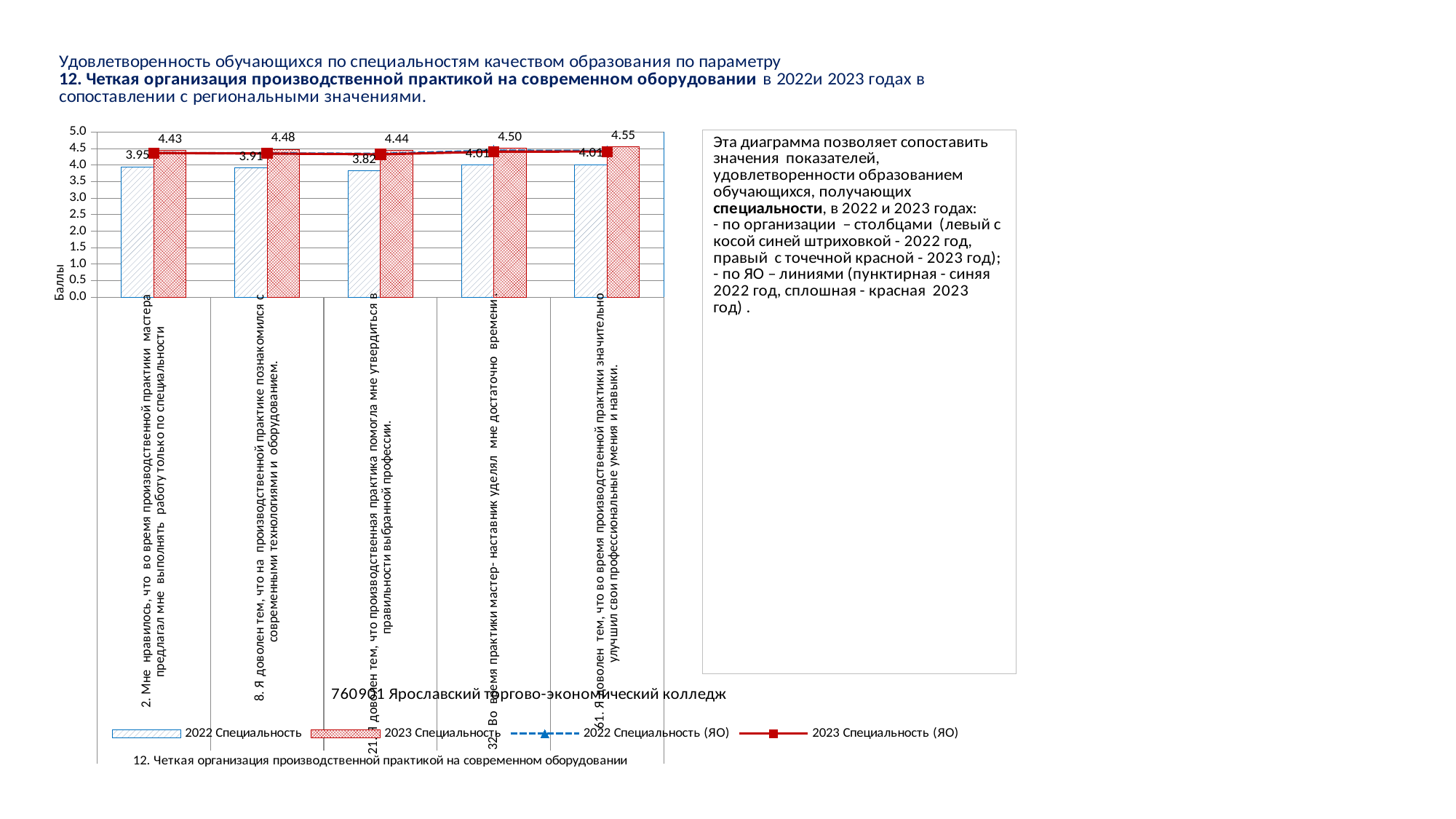
Which item has the highest 2023 Специальность value? 61. Я доволен тем, что во время производственной практики значительно улучшил свои профессиональные умения и навыки (4.55) What is the 2023 Специальность value for item 61 ("Я доволен тем, что во время производственной практики значительно улучшил свои профессиональные умения и навыки")? 4.55 How many series does the chart legend list? 4 What is the 2022 Специальность value for item 21 ("Я доволен тем, что производственная практика помогла мне утвердиться в правильности выбранной профессии")? 3.82 For item 8 ("Я доволен тем, что на производственной практике познакомился с современными технологиями и оборудованием"), how much higher is the 2023 Специальность value than the 2022 value? 0.57 Which item has the lowest 2022 Специальность value? 21. Я доволен тем, что производственная практика помогла мне утвердиться в правильности выбранной профессии (3.82) Which is larger: the 2022 Специальность value for item 32 or for item 2? Item 32 (4.01) Is the 2022 Специальность value for item 8 greater or less than 4.0? less What is the label of the vertical axis of the chart? Баллы For item 61, what is the difference between the 2023 Специальность value and the 2022 Специальность value? 0.54 What is the 2022 Специальность value for item 2 ("Мне нравилось, что во время производственной практики мастер предлагал мне выполнять работу только по специальности")? 3.95 How many items (categories) are shown on the x axis of the chart? 5